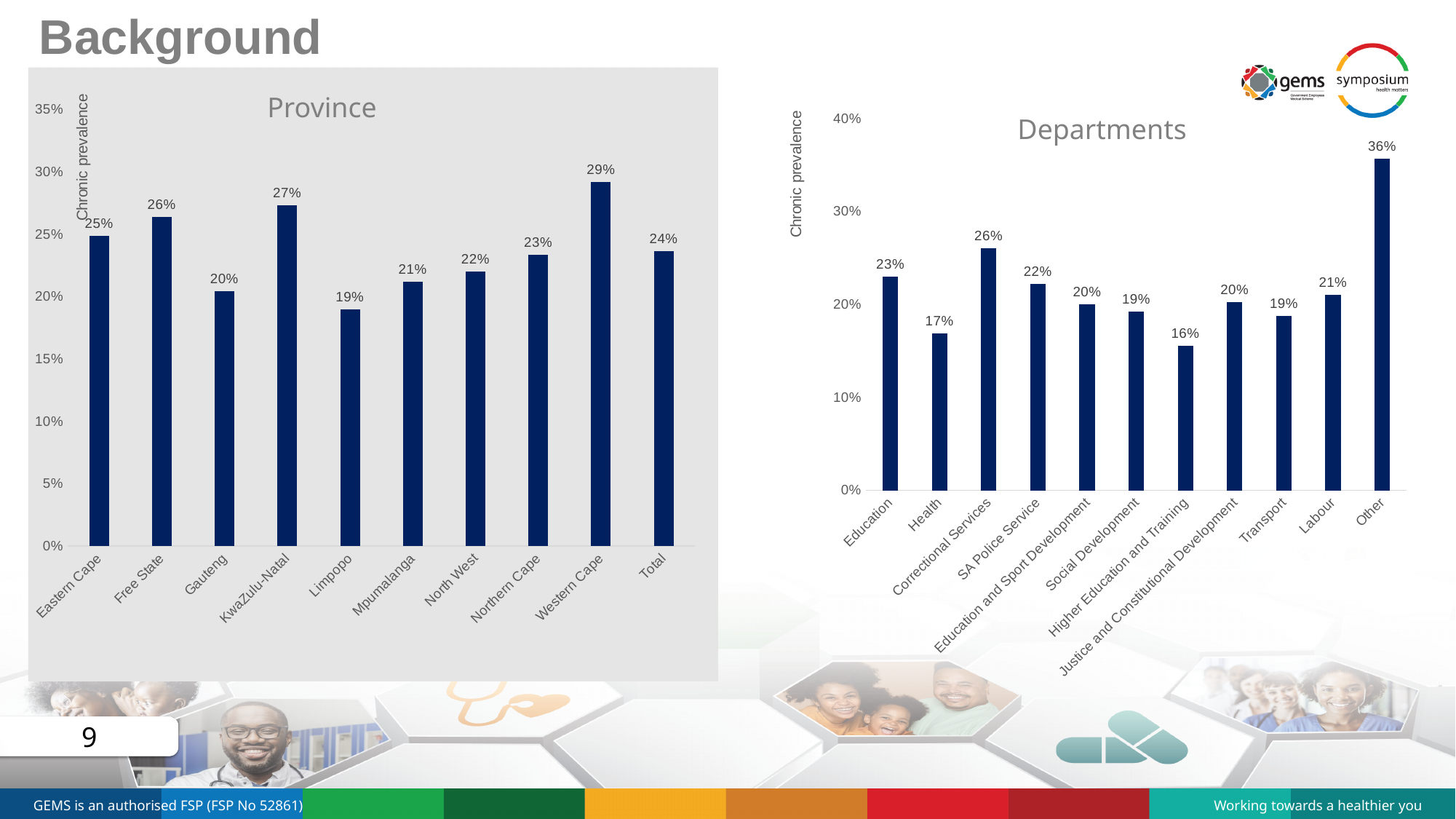
In the Province chart, what is the difference between the values for KwaZulu-Natal and Gauteng? 7% In the Province chart, what is the chronic prevalence for Western Cape? 29% In the Province chart, which province has the lowest chronic prevalence? Limpopo In the Province chart, which is larger: the value for Free State or the value for Northern Cape? Free State In the Province chart, how many bars are plotted? 10 In the Departments chart, which department has the highest chronic prevalence? Other In the Departments chart, which department has the lowest chronic prevalence? Higher Education and Training In the Province chart, what is the value shown for Total? 24% In the Departments chart, what is the difference between the values for Other and Health? 19% In the Departments chart, what is the chronic prevalence for Correctional Services? 26% What type of chart is the Departments chart? Bar chart In the Departments chart, how many departments are plotted? 11